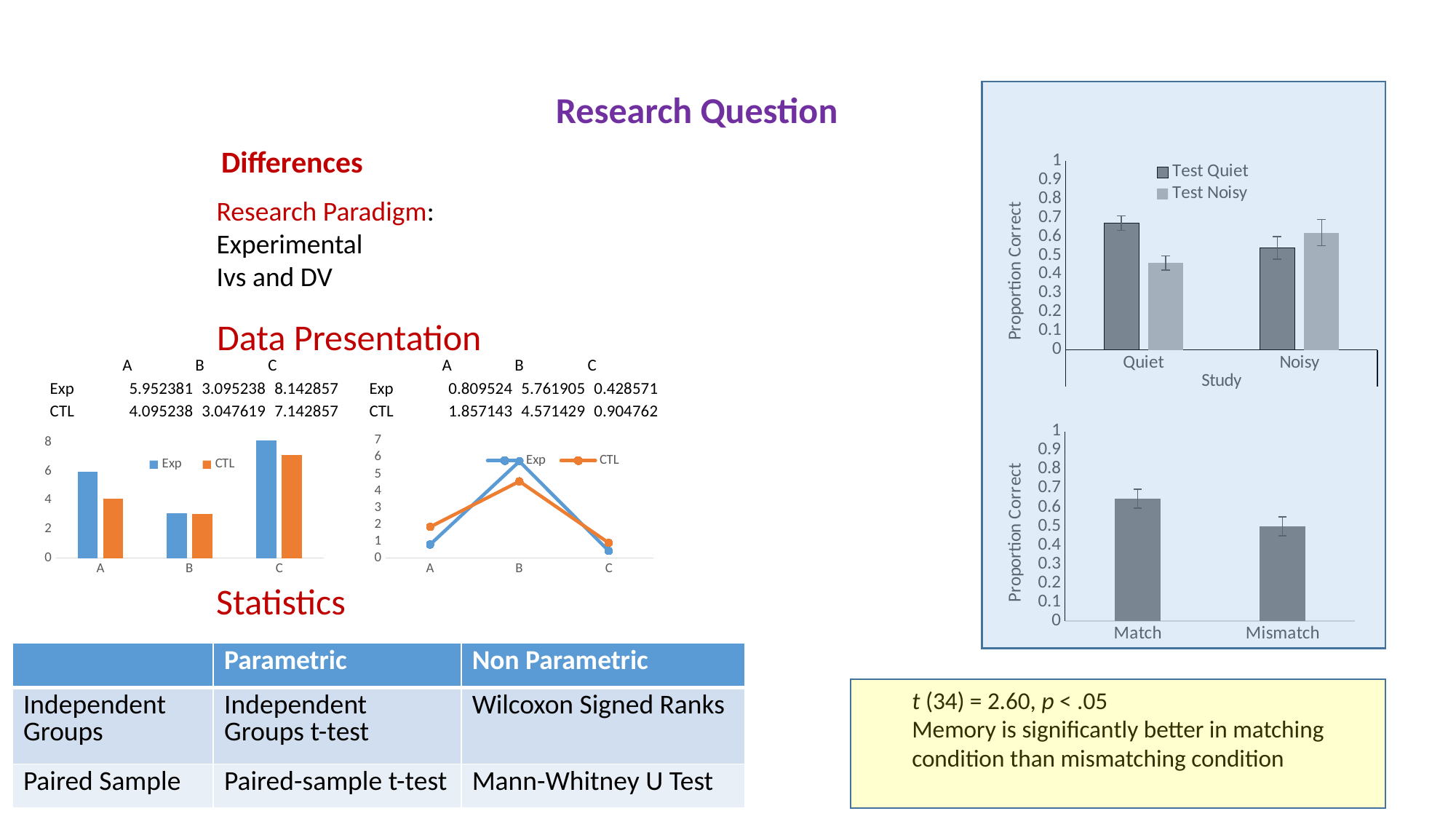
On the line chart in the middle of the slide (Exp vs CTL), which series is higher at category A, Exp or CTL? CTL On the bar chart at the bottom left of the slide (Exp vs CTL), which category has the lowest CTL value? B On the top-right chart (Proportion Correct by Study), is the Test Noisy value for Quiet study greater or less than 0.5? less On the line chart in the middle of the slide (Exp vs CTL), how many categories are on the x axis? 3 On the line chart in the middle of the slide (Exp vs CTL for A, B, C), which category has the highest Exp value? B On the bar chart at the bottom left of the slide (Exp vs CTL for A, B, C), what kind of chart is it? bar chart On the bottom-right chart (Match vs Mismatch), which category has the higher Proportion Correct? Match On the top-right chart (Proportion Correct by Study), how many series does the legend list? 2 On the bar chart at the bottom left of the slide (Exp vs CTL), is the Exp value for C greater or less than 6? greater On the bar chart at the bottom left of the slide (Exp vs CTL), which category has the highest Exp value? C On the bar chart at the bottom left of the slide (Exp vs CTL), how many series does the legend list? 2 On the top-right chart (Proportion Correct by Study), which is larger for the Quiet study condition, Test Quiet or Test Noisy? Test Quiet